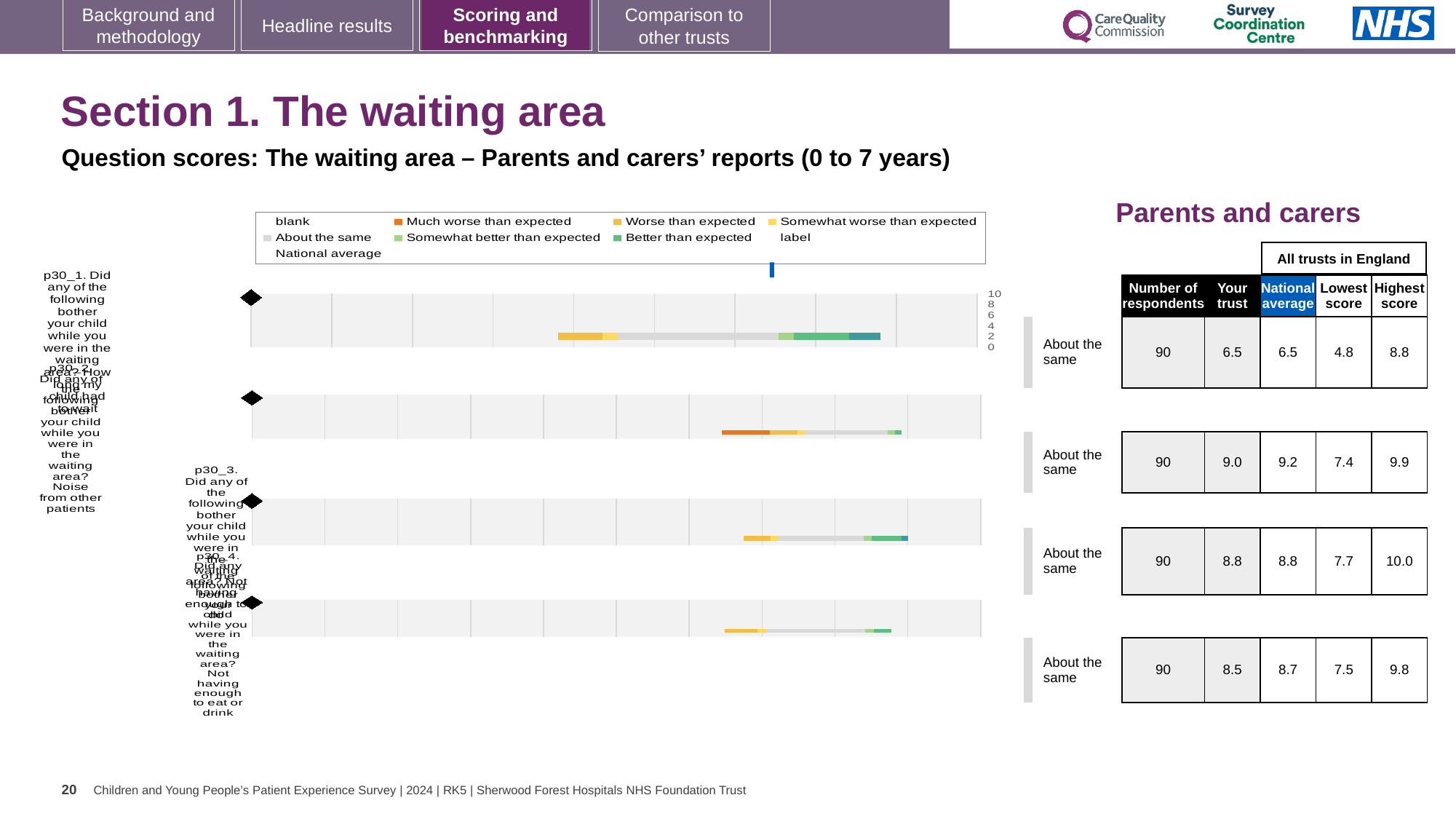
Which question has the lowest 'Your trust' score in the table? p30_1 (noise from other patients) In the table, what is the national average for the second question (p30_2, how long my child had to wait)? 9.2 How many questions (categories) are plotted in the chart? 4 In the table, what is the 'Your trust' score for the first question (p30_1, noise from other patients)? 6.5 In the table, what is the lowest score for the fourth question (p30_4, not having enough to eat or drink)? 7.5 What kind of chart is shown on the slide? bar chart How many respondents are listed for each question in the table? 90 Which legend entry is shown in dark orange? Much worse than expected In the table, what is the highest score for the third question (p30_3, not having enough to do)? 10.0 What is the maximum value shown on the chart's score axis? 10 Which question has the highest 'Your trust' score in the table? p30_2 (how long my child had to wait) What is the difference between the national average and the 'Your trust' score for the fourth question (p30_4)? 0.2